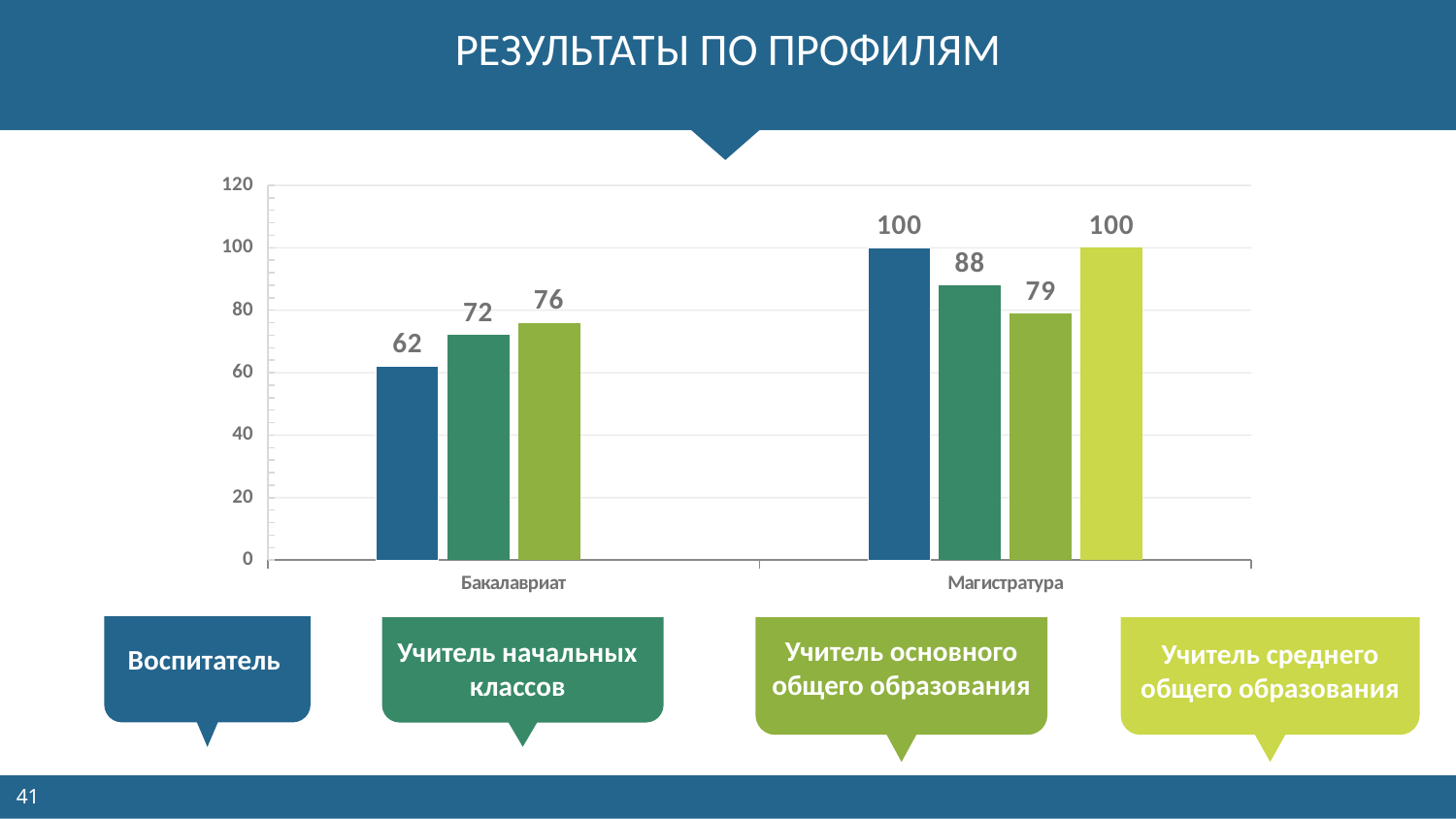
Which is larger: the Учитель начальных классов value for Бакалавриат or for Магистратура? Магистратура What is the value for Учитель среднего общего образования in the Магистратура category? 100 How many categories are shown on the x axis? 2 Which series has the lowest value in the Магистратура category? Учитель основного общего образования What is the title of the slide containing the chart? РЕЗУЛЬТАТЫ ПО ПРОФИЛЯМ What is the value for Учитель основного общего образования in the Бакалавриат category? 76 What is the difference between the Воспитатель values for Магистратура and Бакалавриат? 38 What is the value for Воспитатель in the Бакалавриат category? 62 What is the value for Учитель начальных классов in the Магистратура category? 88 Which series has the lowest value in the Бакалавриат category? Воспитатель What type of chart is shown on the slide? Bar chart How many series does the legend list? 4